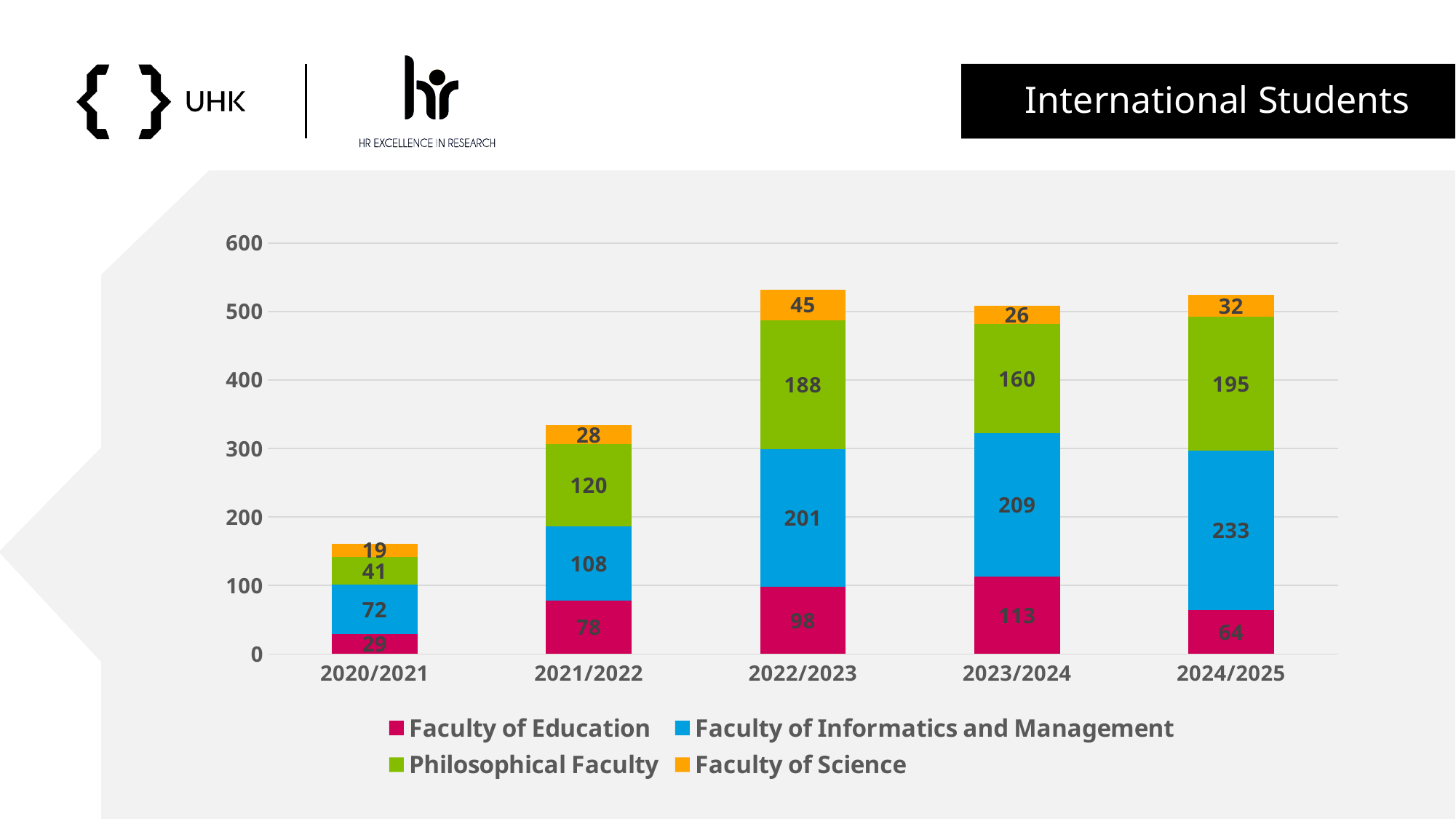
What is the difference between the Faculty of Education values in 2023/2024 and 2024/2025? 49 What is the total of the stacked bar for 2022/2023? 532 What is the value for the Faculty of Science in 2020/2021? 19 In which academic year is the Faculty of Science value lowest? 2020/2021 What is the title shown in the black box at the top right of the slide? International Students How many academic years are shown on the x axis? 5 What is the value for the Faculty of Informatics and Management in 2024/2025? 233 In which academic year is the Faculty of Education value highest? 2023/2024 What type of chart is shown on the slide? stacked bar chart How many series does the legend list? 4 Which is larger: the Philosophical Faculty value in 2021/2022 or in 2023/2024? 2023/2024 What is the value for the Philosophical Faculty in 2022/2023? 188